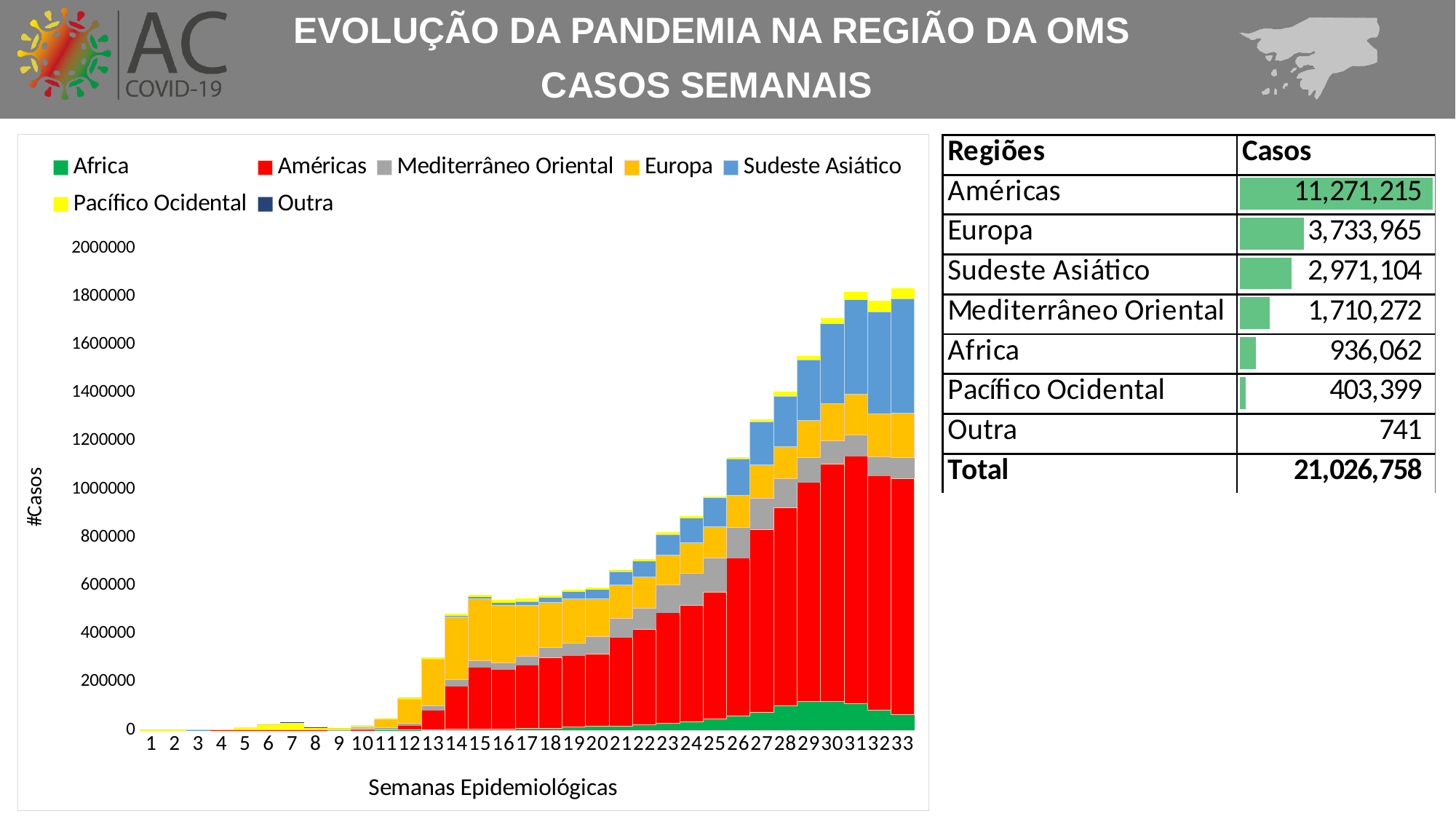
How many epidemiological weeks are plotted along the x axis? 33 Is the total stacked value for week 15 greater or less than 400000? greater Is the total stacked value for week 20 greater or less than 800000? less What kind of chart is shown on the slide? bar chart How many series does the chart legend list? 7 Which colour represents Américas in the chart legend? red Is the total stacked value for week 33 greater or less than 1600000? greater Which week has the larger total stacked value, week 33 or week 20? week 33 What is the title of the x axis? Semanas Epidemiológicas Do the weekly case totals generally rise or fall from week 1 to week 33? rise